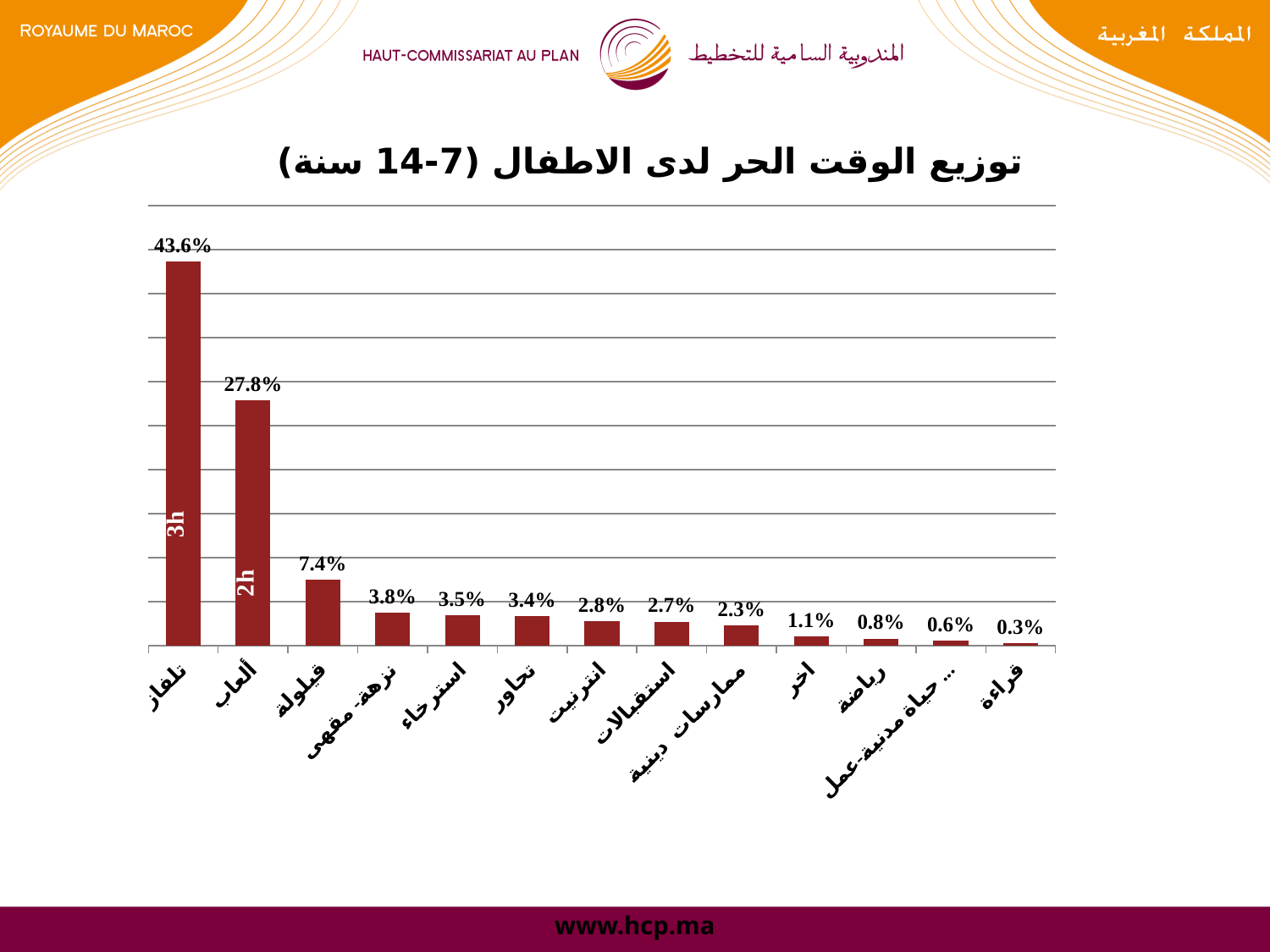
What is the value for انترنت? 2.8% What is the value for قيلولة? 7.4% What label is printed inside the bar for تلفاز? 3h What is the value for قراءة? 0.3% What is the value for ألعاب? 27.8% How many categories are shown on the x axis? 13 Which category has the lowest value? قراءة Which is larger, the value for رياضة or the value for اخر? اخر What is the value for تلفاز? 43.6% Which category has the highest value? تلفاز What is the difference between the values for تلفاز and ألعاب? 15.8% What type of chart is shown on the slide? bar chart